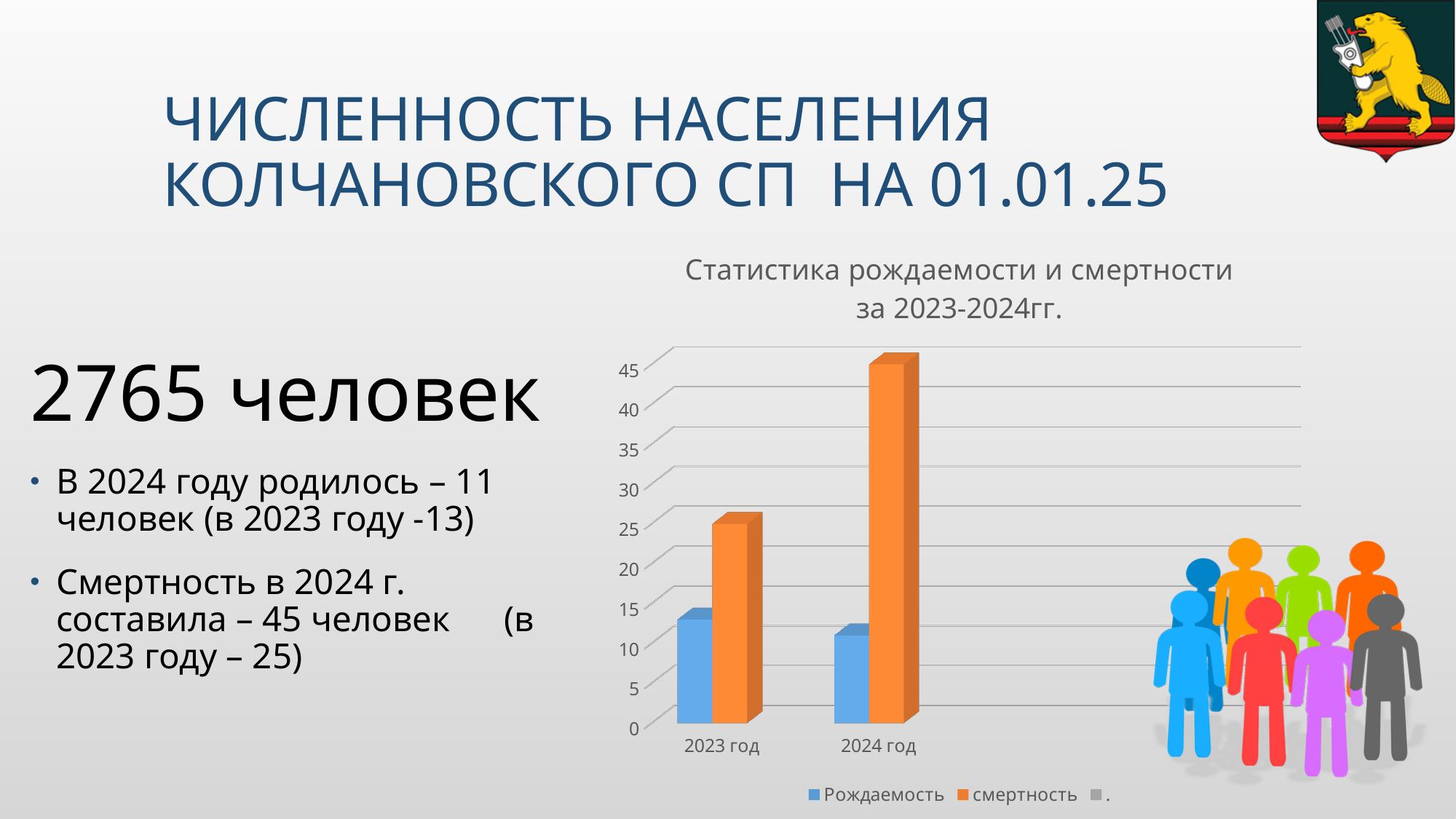
What is the value of смертность (deaths) for 2024 год in the chart? 45 How many year categories are shown on the x axis of the chart? 2 Is the Рождаемость (births) value for 2023 год greater or less than 15? less Does the смертность (deaths) series rise or fall from 2023 год to 2024 год? rise By how much did смертность (deaths) increase from 2023 год to 2024 год? 20 What is the value of Рождаемость (births) for 2024 год according to the slide? 11 Which year has the higher Рождаемость (births) value, 2023 год or 2024 год? 2023 год Which bar is the tallest in the chart? смертность for 2024 год What is the value of Рождаемость (births) for 2023 год according to the slide? 13 Is the смертность (deaths) value for 2024 год greater or less than 40? greater What is the value of смертность (deaths) for 2023 год in the chart? 25 What kind of chart is shown on the slide? bar chart